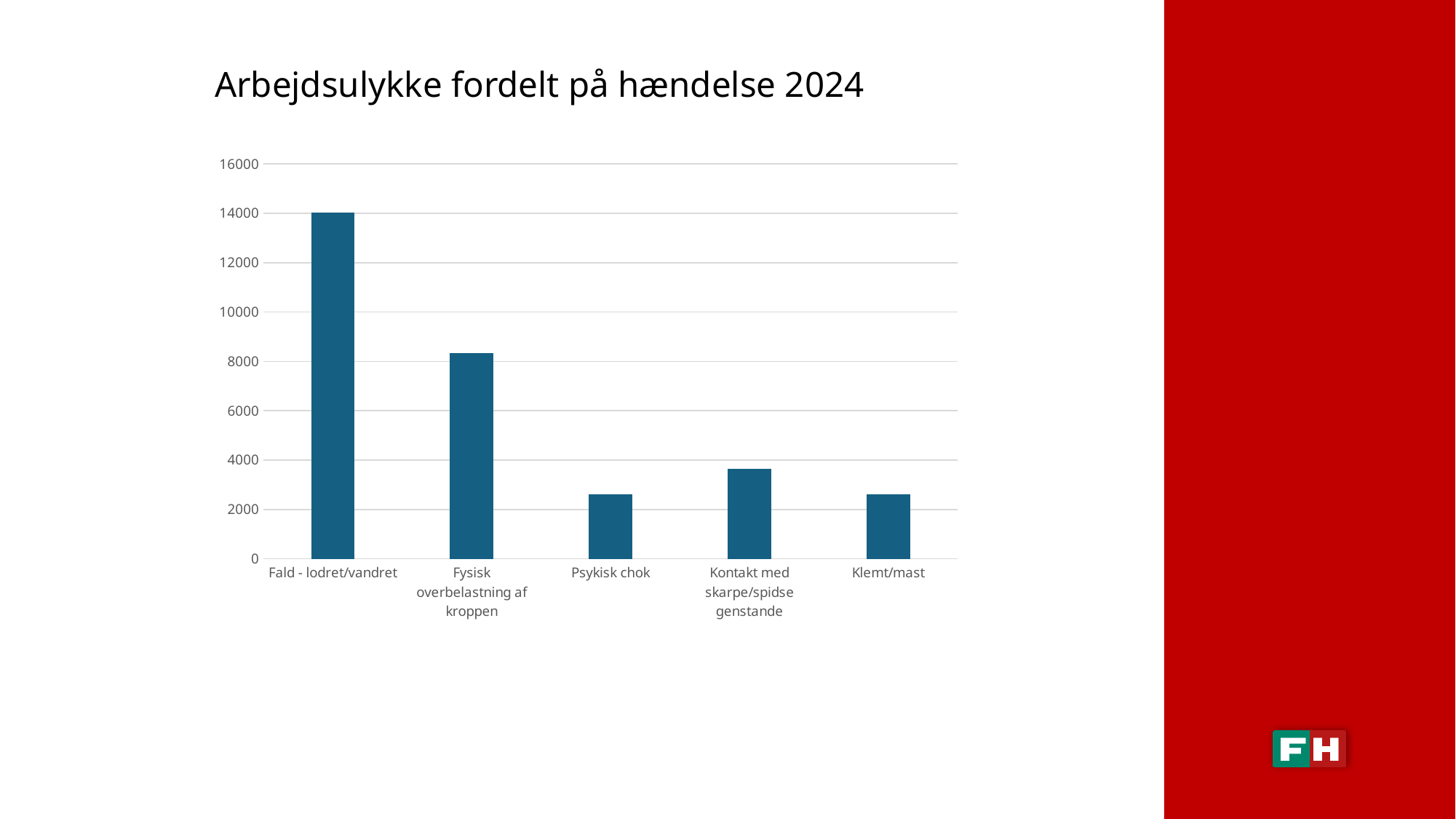
Is the value for Psykisk chok greater or less than 4000? less Is the value for Fysisk overbelastning af kroppen greater or less than 10000? less Is the value for Kontakt med skarpe/spidse genstande greater or less than 4000? less How many categories are shown on the x axis of the chart? 5 Which is larger, the value for Fald - lodret/vandret or the value for Fysisk overbelastning af kroppen? Fald - lodret/vandret What kind of chart is shown on the slide? bar chart Which is larger, the value for Kontakt med skarpe/spidse genstande or the value for Psykisk chok? Kontakt med skarpe/spidse genstande What is the title of the chart? Arbejdsulykke fordelt på hændelse 2024 Which category has the highest value in the chart? Fald - lodret/vandret